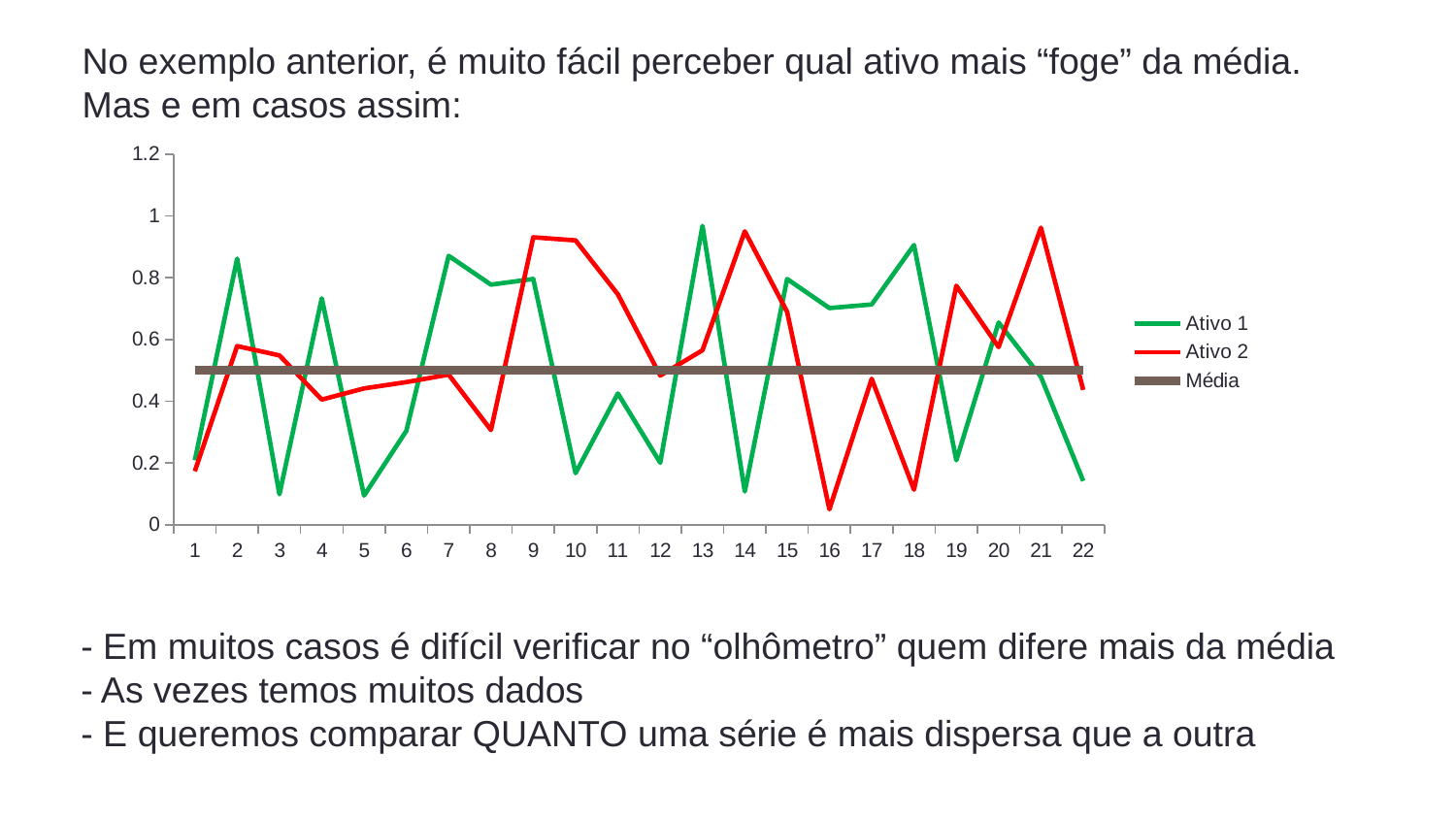
At point 3, which series has the larger value, Ativo 1 or Ativo 2? Ativo 2 Is the value of Ativo 1 at point 13 greater or less than 0.8? greater Is the value of Ativo 1 at point 3 greater or less than 0.2? less Does the Média line rise, fall, or stay flat across the x axis? Stays flat How many points are plotted along the x axis for each series? 22 What kind of chart is shown on the slide? Line chart How many series does the legend list? 3 Is the value of Ativo 2 at point 16 greater or less than 0.2? less Which series are listed in the legend? Ativo 1, Ativo 2, Média At point 13, which series has the larger value, Ativo 1 or Ativo 2? Ativo 1 What colour is the line for Ativo 1? Green